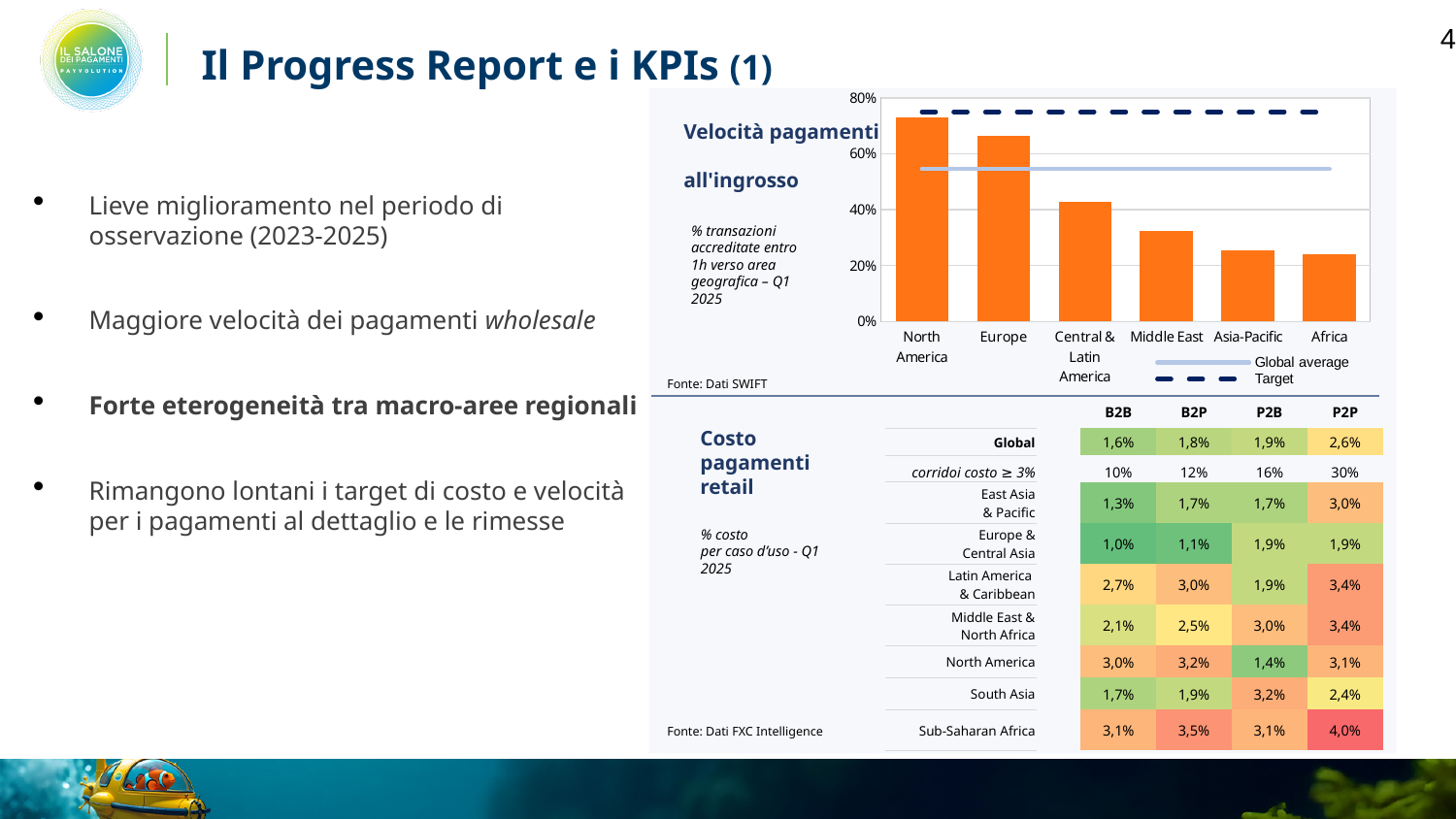
In the 'Velocità pagamenti all'ingrosso' chart, do the bar values rise or fall from North America to Africa? fall In the 'Velocità pagamenti all'ingrosso' chart, is the value for Africa greater or less than 20%? greater In the 'Velocità pagamenti all'ingrosso' chart, is the value for North America greater or less than 60%? greater In the 'Velocità pagamenti all'ingrosso' chart, what kind of chart is used to show the values by geographic area? bar chart In the 'Velocità pagamenti all'ingrosso' chart, is the value for Central & Latin America greater or less than 60%? less In the 'Velocità pagamenti all'ingrosso' chart, which legend entry is drawn as a dashed line? Target In the 'Velocità pagamenti all'ingrosso' chart, which geographic area has the highest bar? North America In the 'Velocità pagamenti all'ingrosso' chart, which is larger, the value for Europe or the value for Middle East? Europe In the 'Costo pagamenti retail' table, what is the P2P value for Sub-Saharan Africa? 4,0% In the 'Velocità pagamenti all'ingrosso' chart, how many entries does the legend list? 2 In the 'Velocità pagamenti all'ingrosso' chart, how many geographic areas are shown on the x axis? 6